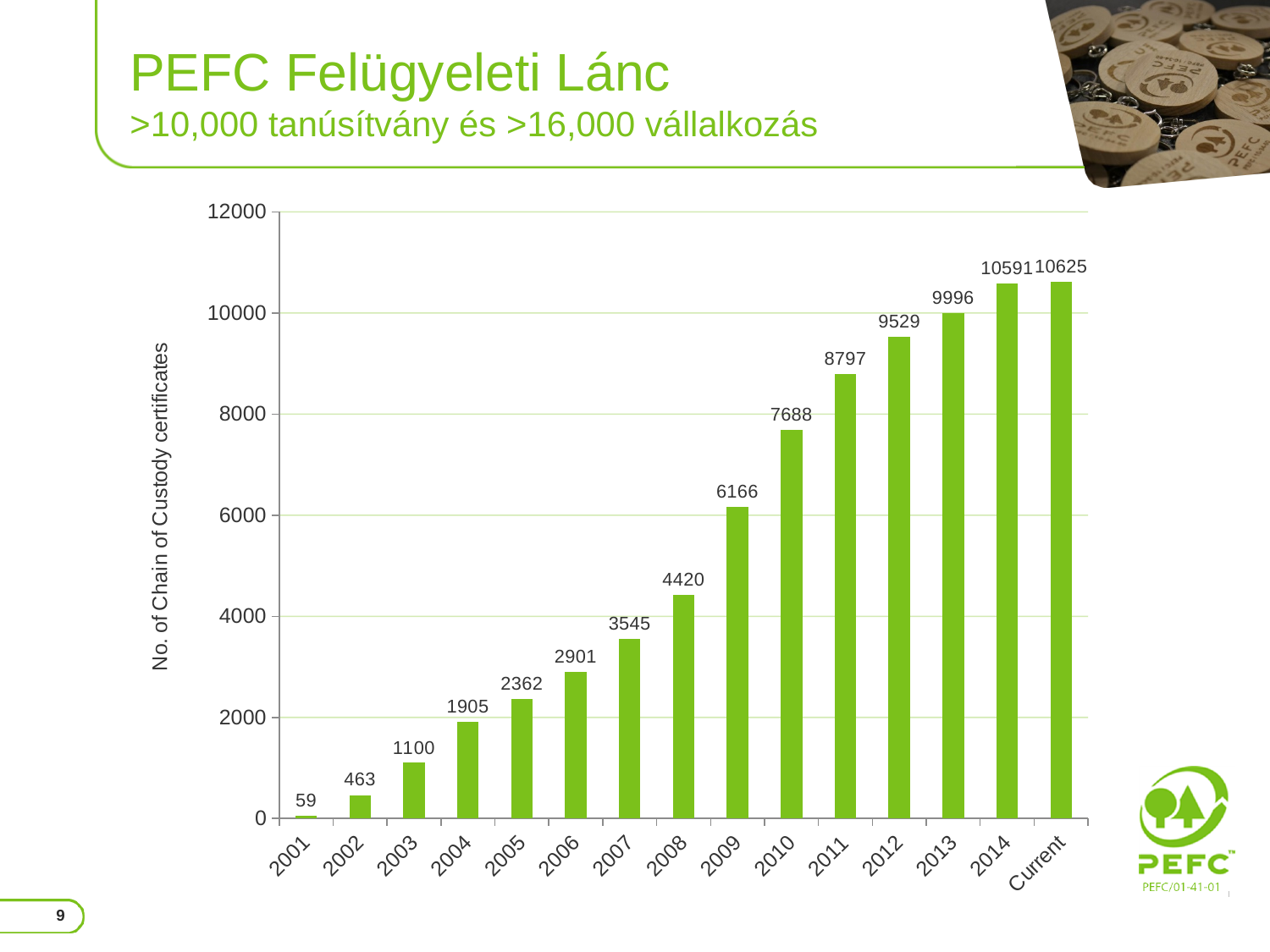
What kind of chart is shown on the slide? bar chart What is the label of the y axis? No. of Chain of Custody certificates What is the value shown for the 'Current' bar? 10625 Which category has the lowest value? 2001 How many categories are plotted along the x axis? 15 What is the number of Chain of Custody certificates for 2009? 6166 Which is larger, the value for 2008 or the value for 2007? 2008 Which category has the highest value? Current What is the value shown for 2001? 59 Do the values rise or fall from 2001 to Current along the x axis? rise Is the value for 2011 greater or less than 8000? greater What is the difference between the values for 2014 and 2013? 595